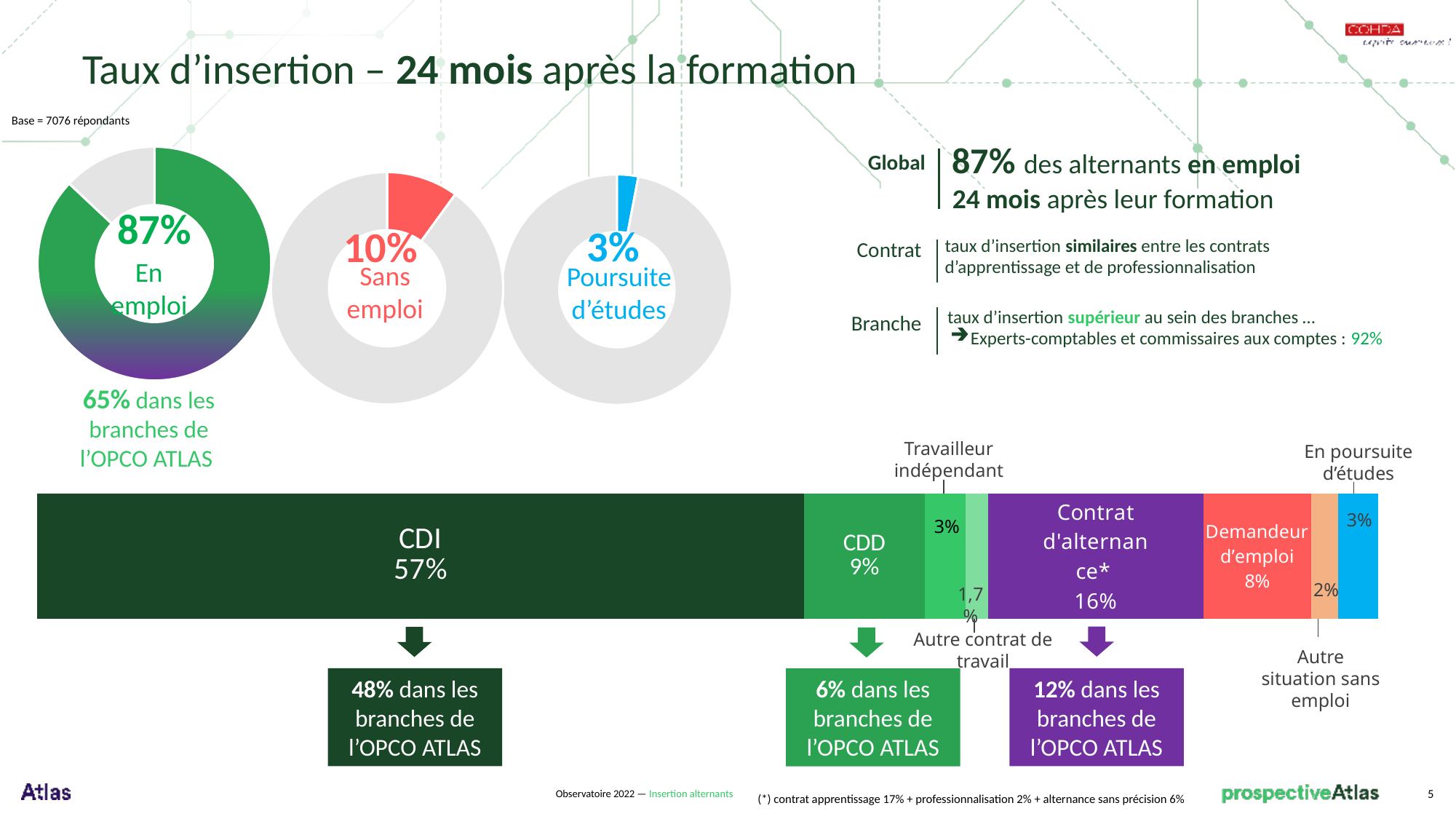
In the stacked bar chart, what is the value for Contrat d'alternance? 16% In the stacked bar chart, which segment has the smallest value? Autre contrat de travail In the stacked bar chart, which segment has the largest value? CDI In the stacked bar chart, what is the value for Autre contrat de travail? 1,7% What percentage does the first donut chart (En emploi) show? 87% In the stacked bar chart, what is the value for CDD? 9% In the stacked bar chart, what is the difference between the CDI value and the Contrat d'alternance value? 41% In the stacked bar chart, what is the value for CDI? 57% In the stacked bar chart, which is larger: CDD or Demandeur d'emploi? CDD How many segments does the stacked bar chart contain? 8 What percentage does the donut chart labelled Sans emploi show? 10% In the stacked bar chart, what is the value for Demandeur d'emploi? 8%